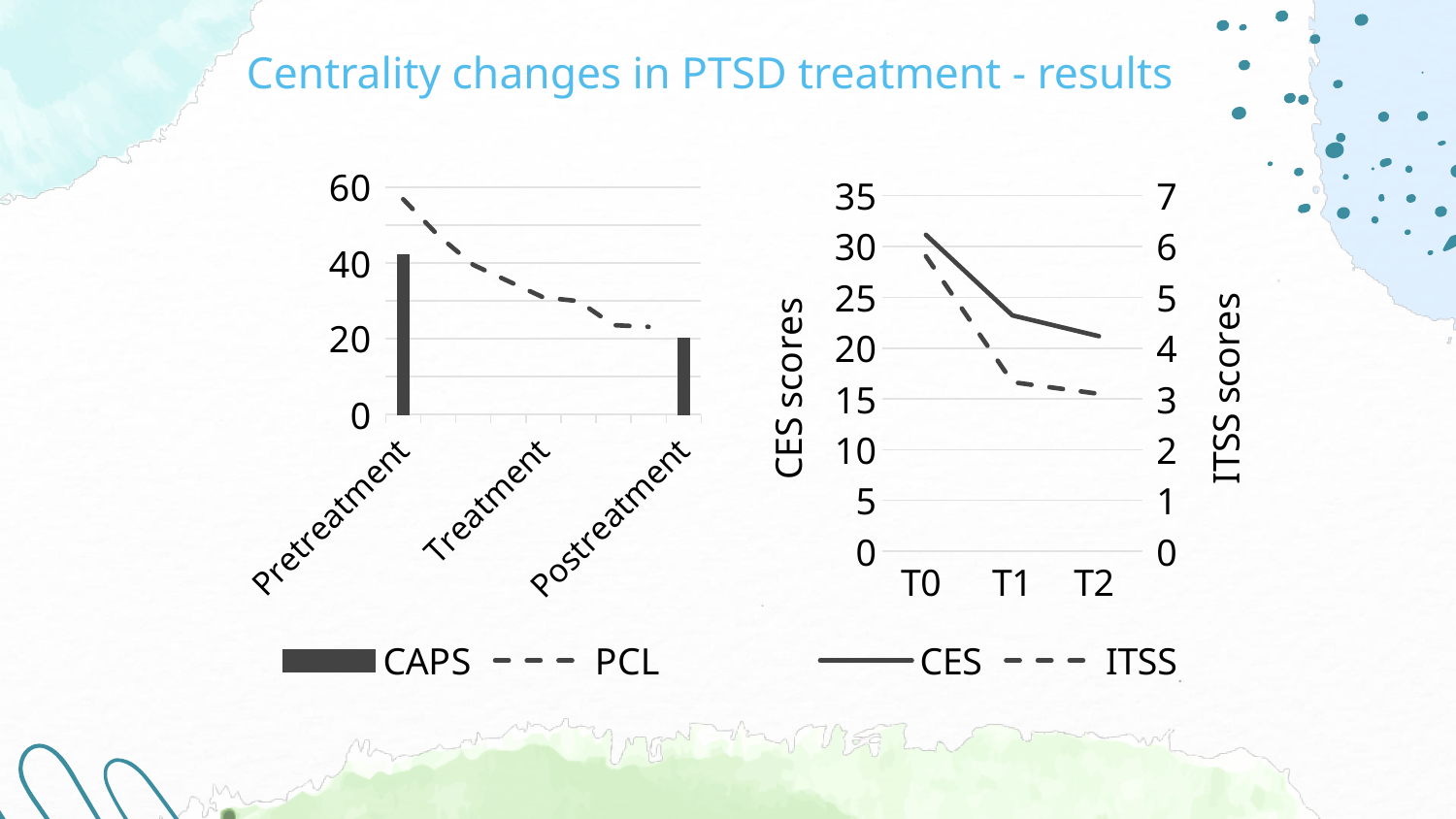
In the left chart, do the PCL values rise or fall from Pretreatment to Postreatment? fall What is the label of the right-hand vertical axis of the right chart? ITSS scores How many categories are shown on the x axis of the left chart? 3 In the right chart, is the ITSS value at T2 greater or less than 4? less In the right chart, is the CES value at T0 greater or less than 25? greater What type of chart is the right chart? line chart In the left chart, is the CAPS value for Pretreatment greater or less than 20? greater In the left chart, which is larger, the CAPS value for Pretreatment or the CAPS value for Postreatment? Pretreatment In the right chart, do the CES values rise or fall from T0 to T2? fall How many series does the legend of the left chart list? 2